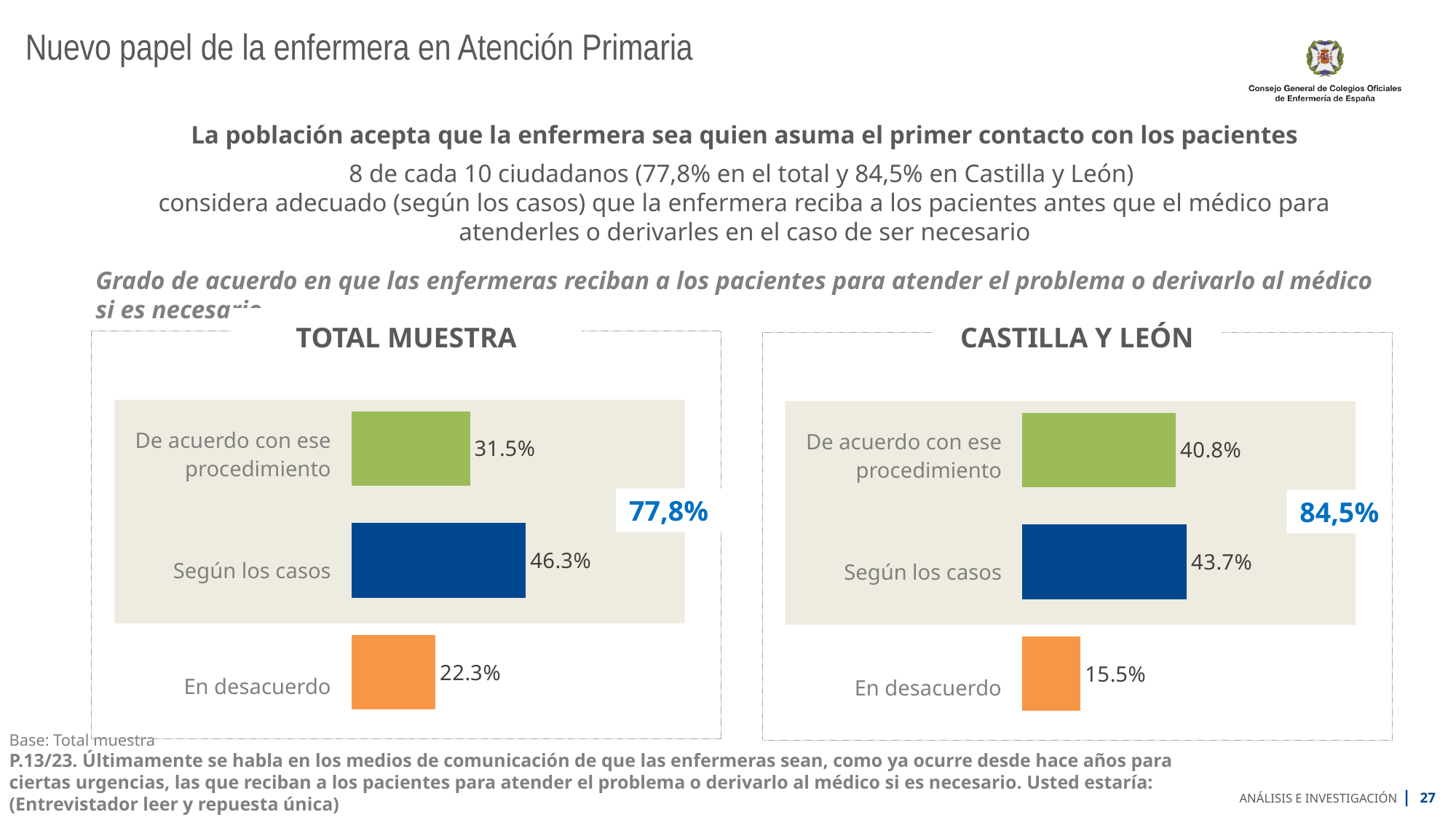
In the TOTAL MUESTRA chart, what is the difference between "Según los casos" and "De acuerdo con ese procedimiento"? 14.8% Which is larger: "En desacuerdo" in the TOTAL MUESTRA chart or "En desacuerdo" in the CASTILLA Y LEÓN chart? TOTAL MUESTRA How many categories does the TOTAL MUESTRA chart show? 3 In the CASTILLA Y LEÓN chart, what is the value for "En desacuerdo"? 15.5% In the CASTILLA Y LEÓN chart, what combined percentage is highlighted in blue next to the first two bars? 84,5% In the CASTILLA Y LEÓN chart, what is the difference between "De acuerdo con ese procedimiento" and "En desacuerdo"? 25.3% In the TOTAL MUESTRA chart, what is the value for "Según los casos"? 46.3% In the TOTAL MUESTRA chart, what is the value for "En desacuerdo"? 22.3% What kind of chart is the CASTILLA Y LEÓN chart? Bar chart In the CASTILLA Y LEÓN chart, what is the value for "De acuerdo con ese procedimiento"? 40.8% In the CASTILLA Y LEÓN chart, which category has the lowest value? En desacuerdo In the TOTAL MUESTRA chart, which category has the highest value? Según los casos